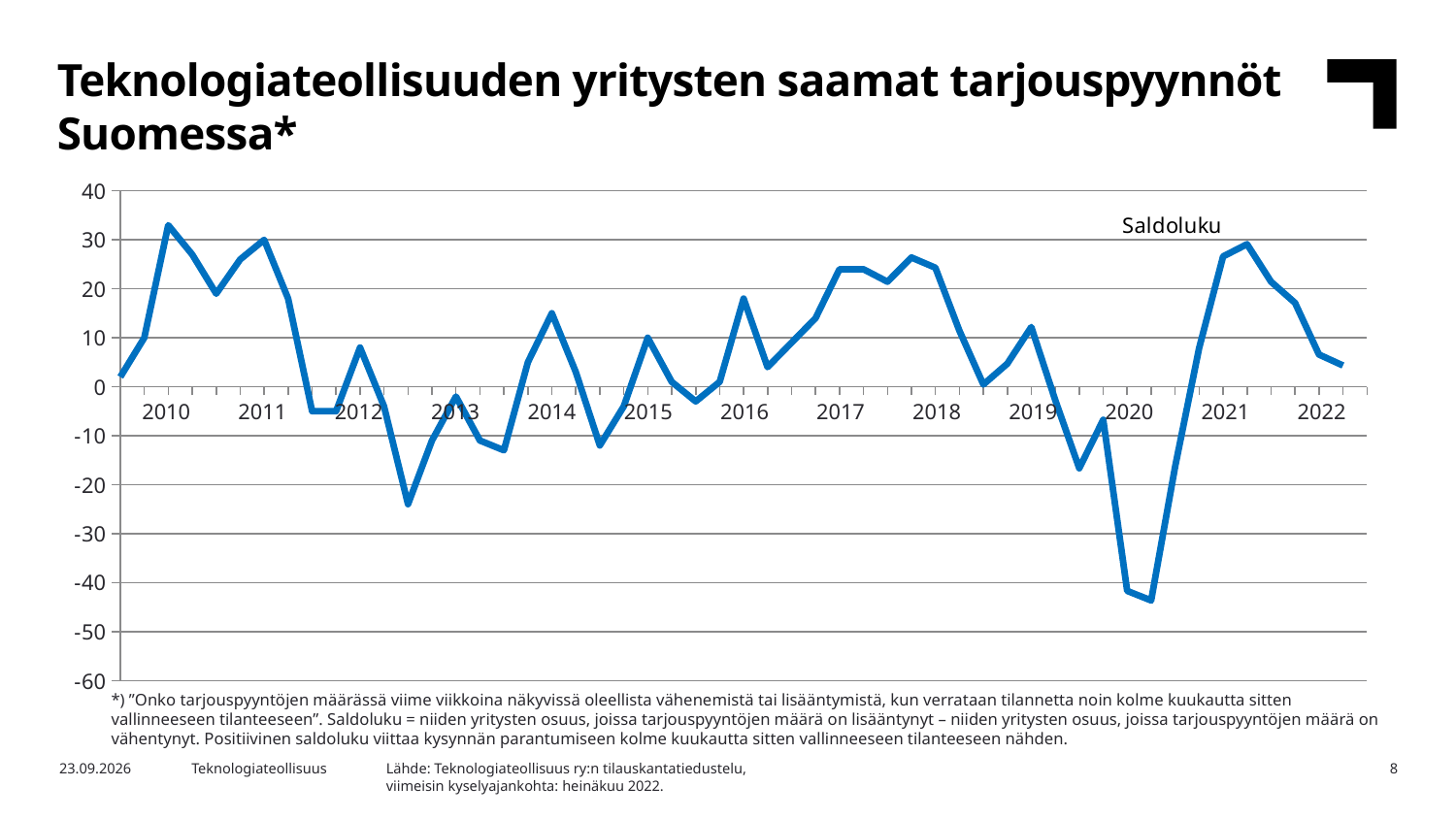
Is the lowest value in 2012 greater or less than -20? less What is the title of the chart on the slide? Teknologiateollisuuden yritysten saamat tarjouspyynnöt Suomessa* Is the peak value in 2021 greater or less than 20? greater Is the last plotted value in 2022 greater or less than 10? less Do the values rise or fall from the 2021 peak to the end of 2022? fall What is the name of the series plotted in the chart? Saldoluku What kind of chart is shown on the slide? line chart How many years are labelled on the x axis of the chart? 13 Which is larger, the lowest value in 2020 or the lowest value in 2012? the lowest value in 2012 In which year does the line reach its lowest point? 2020